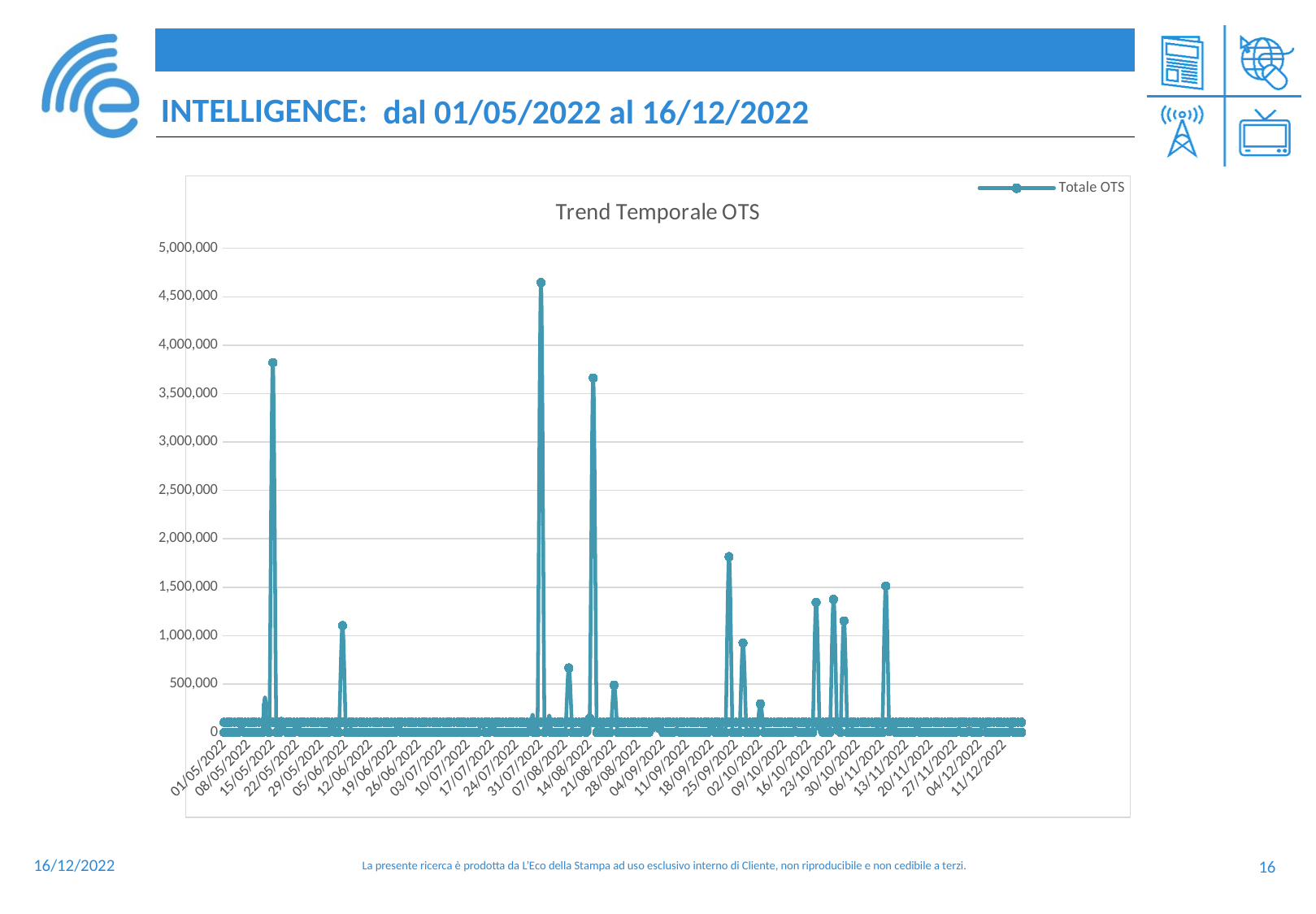
Is the peak of Totale OTS near 05/06/2022 higher or lower than the peak near 25/09/2022? lower Is the peak of Totale OTS near 15/05/2022 greater or less than 3,500,000? greater What is the name of the series shown in the chart legend? Totale OTS Is the peak of Totale OTS near 06/11/2022 greater or less than 1,000,000? greater What is the title of the chart? Trend Temporale OTS Is the peak of Totale OTS near 25/09/2022 greater or less than 2,000,000? less Is the peak of Totale OTS between 31/07/2022 and 07/08/2022 higher or lower than the peak near 15/05/2022? higher What kind of chart is shown on the slide? line chart How many series does the chart legend list? 1